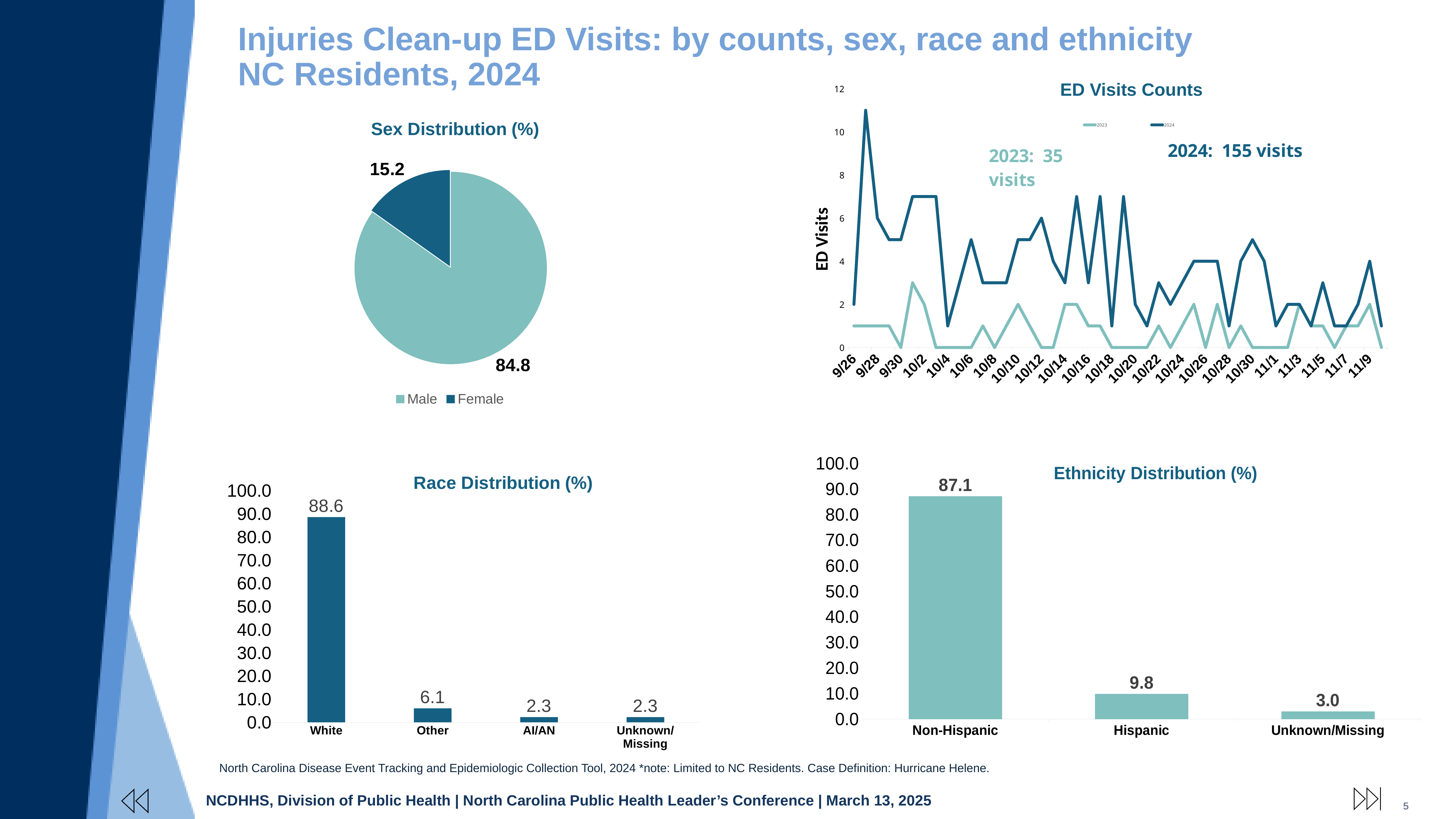
In the Sex Distribution (%) pie chart, which category has the larger share? Male In the ED Visits Counts chart, how many total visits are noted for 2024? 155 visits In the Race Distribution (%) chart, how many race categories are shown? 4 In the Ethnicity Distribution (%) chart, what is the difference between the values for Non-Hispanic and Hispanic? 77.3 In the Sex Distribution (%) pie chart, what is the value shown for Male? 84.8 In the Sex Distribution (%) pie chart, what is the value shown for Female? 15.2 In the Ethnicity Distribution (%) chart, what is the value for Hispanic? 9.8 In the Ethnicity Distribution (%) chart, which category has the lowest value? Unknown/Missing In the Race Distribution (%) chart, what is the value for Other? 6.1 In the ED Visits Counts chart, how many series does the legend list? 2 In the Race Distribution (%) chart, what is the value for White? 88.6 In the Race Distribution (%) chart, what is the difference between the values for White and Other? 82.5